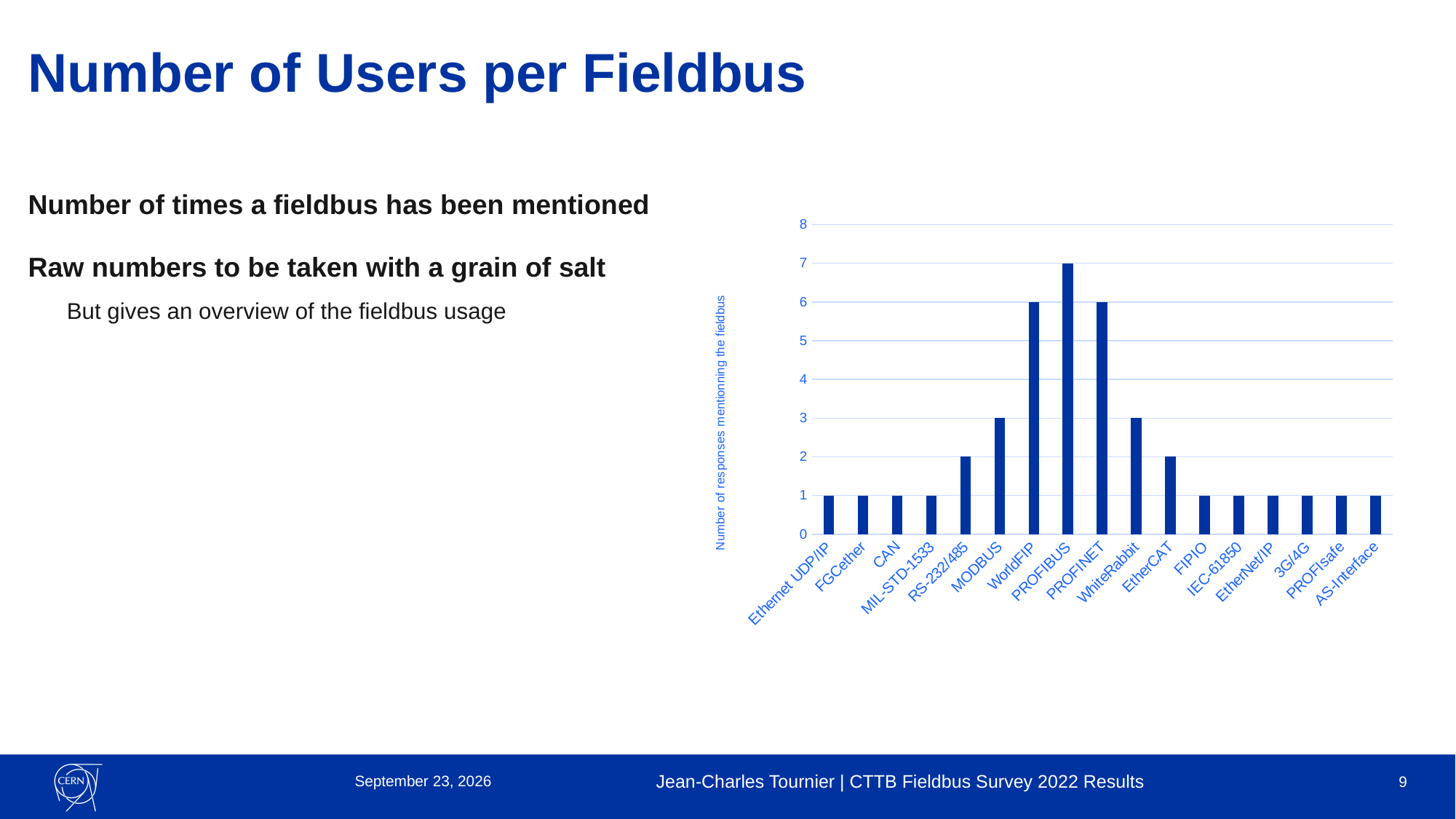
How many responses mention MODBUS? 3 Which has more responses, WhiteRabbit or RS-232/485? WhiteRabbit What is the label of the vertical axis of the chart? Number of responses mentionning the fieldbus Is the value for PROFINET greater or less than 5? greater What is the difference between the number of responses for PROFIBUS and PROFINET? 1 How many responses mention PROFIBUS? 7 What type of chart is shown on the slide? bar chart How many responses mention EtherCAT? 2 Which fieldbus has the highest number of responses mentioning it? PROFIBUS What is the highest value shown on the vertical axis of the chart? 8 How many responses mention WorldFIP? 6 How many fieldbuses are shown on the x axis of the chart? 17